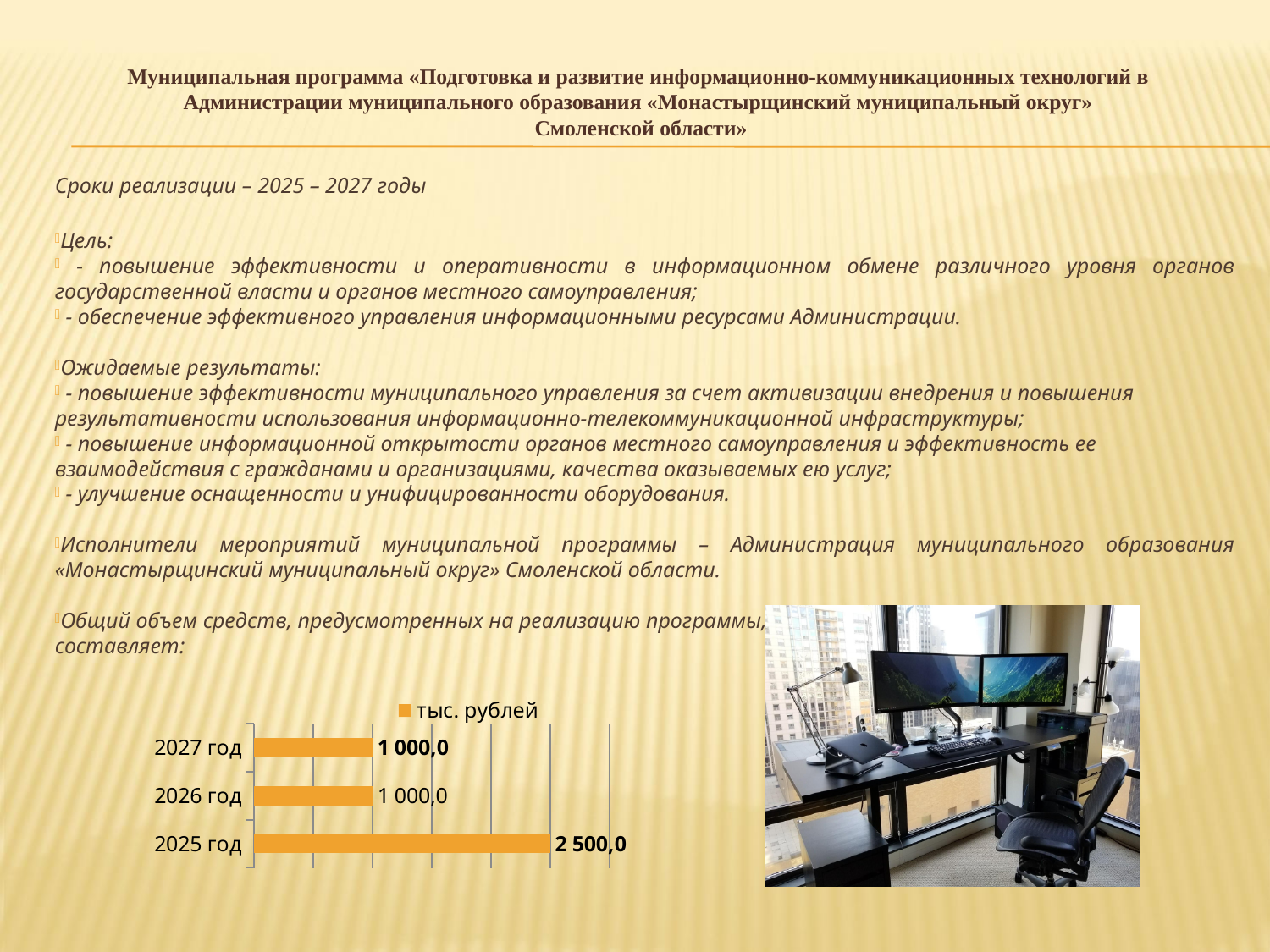
What is the legend entry of the chart? тыс. рублей Which year has the highest value? 2025 год What is the total of the values for all three years? 4 500,0 What colour are the bars in the chart? orange How many categories (years) are shown in the chart? 3 What is the value for 2027 год? 1 000,0 What kind of chart is shown on the slide? bar chart What is the value for 2026 год? 1 000,0 What is the value for 2025 год? 2 500,0 Which is larger, the value for 2025 год or the value for 2027 год? 2025 год What is the difference between the values for 2025 год and 2026 год? 1 500,0 How many series does the legend list? 1